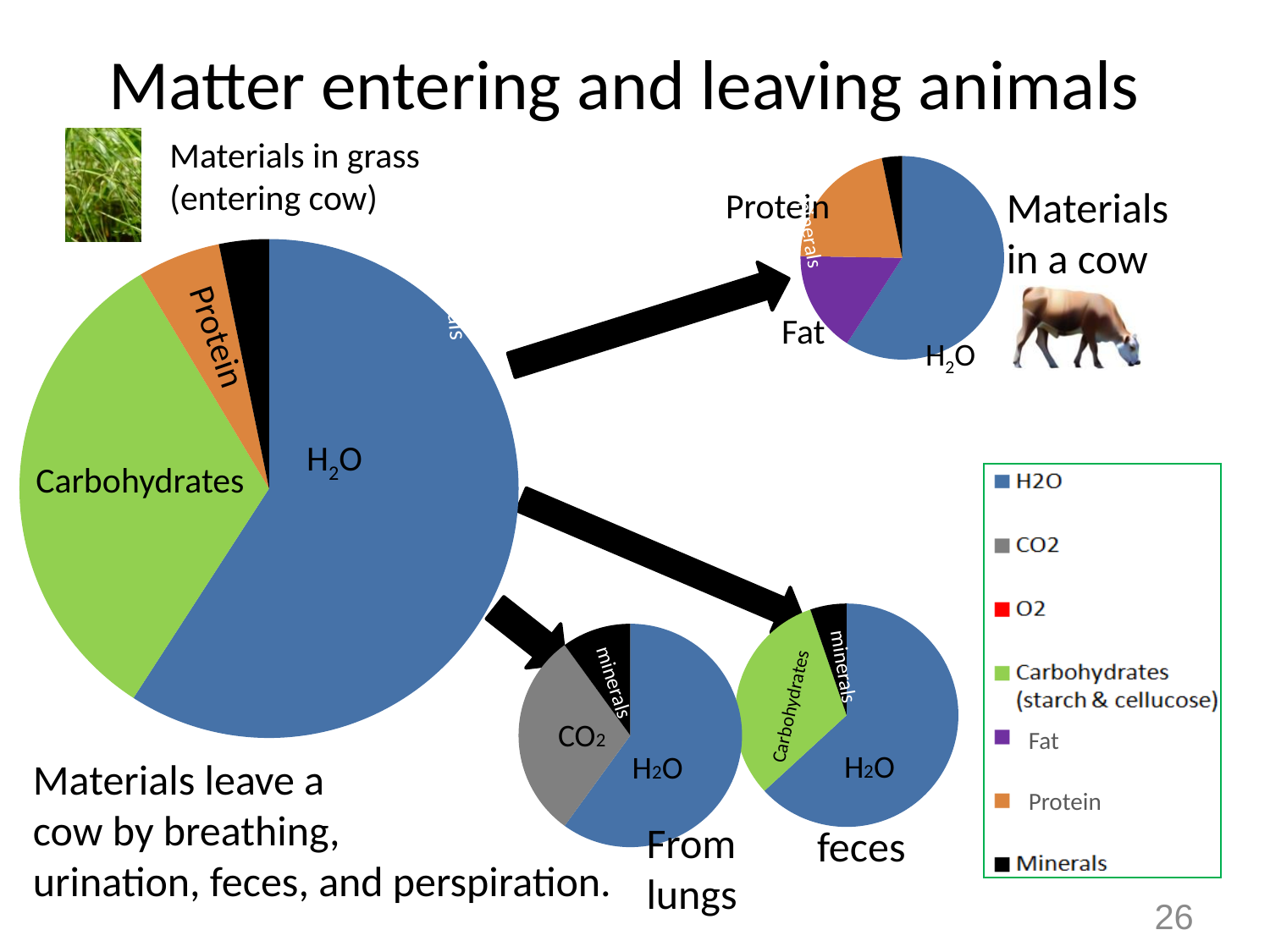
How many slices does the 'feces' pie chart have? 3 In the 'Materials in grass (entering cow)' pie chart, which material has the smallest share? Minerals In the 'From lungs' pie chart, which material has the largest share? H2O What kind of chart is used to show the materials in grass entering the cow? Pie chart In the 'Materials in a cow' pie chart, which material has the largest share? H2O In the 'From lungs' pie chart, which is larger: CO2 or minerals? CO2 In the 'Materials in a cow' pie chart, which material has the smallest share? Minerals In the 'Materials in grass (entering cow)' pie chart, which material has the largest share? H2O According to the legend, what colour represents Carbohydrates? Green How many slices does the 'Materials in grass (entering cow)' pie chart have? 4 How many entries does the legend on the slide list? 7 In the 'Materials in grass (entering cow)' pie chart, which is larger: Carbohydrates or Protein? Carbohydrates